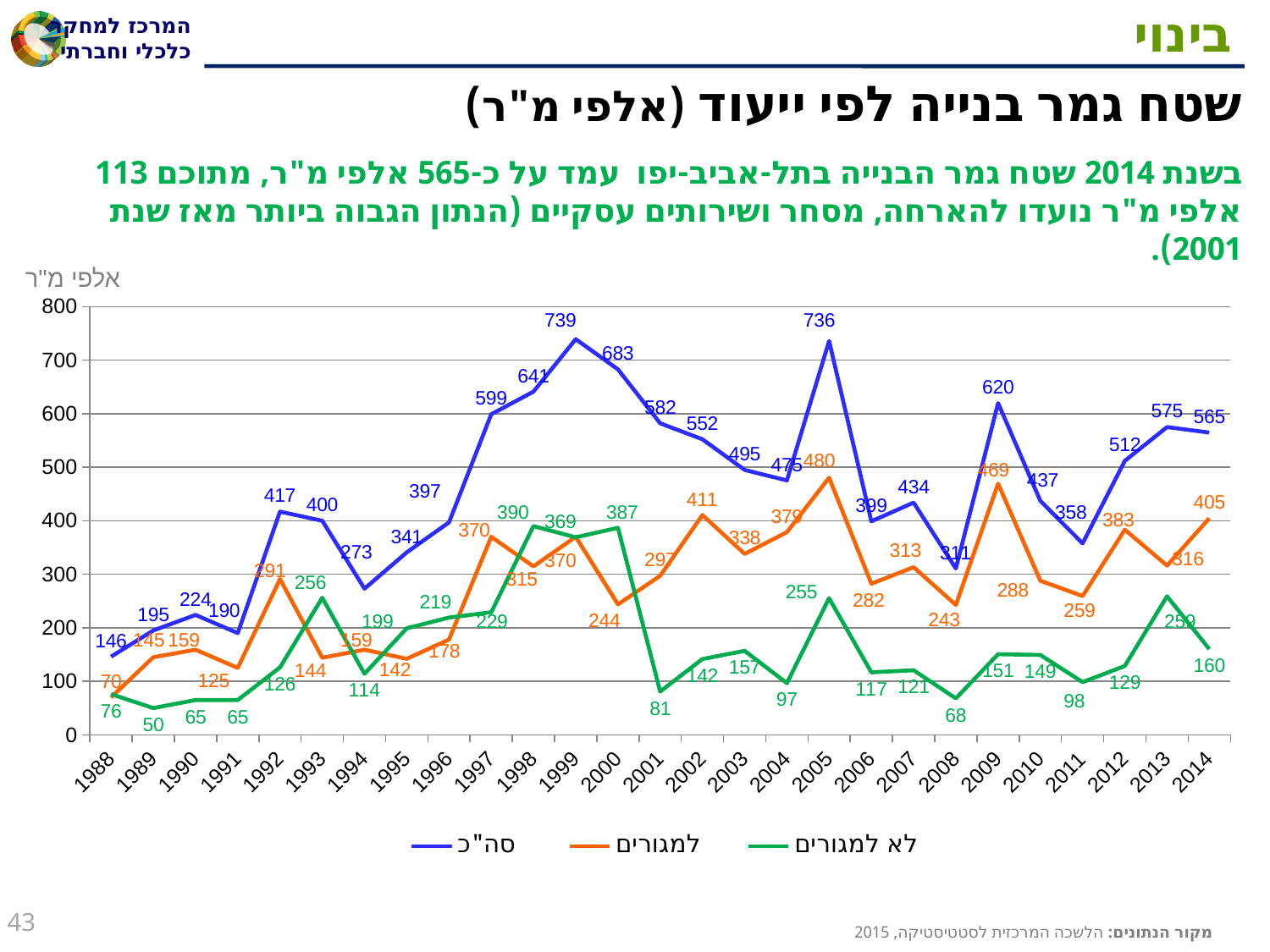
What is the value of the סה"כ series in 2014? 565 In which year does the סה"כ series reach its highest value? 1999 What is the value of the למגורים series in 2014? 405 How many series does the legend list? 3 What is the value of the לא למגורים series in 1998? 390 Does the סה"כ series rise or fall from 2011 to 2013? rise What is the unit label shown above the y axis? אלפי מ"ר How many years are plotted along the x axis? 27 What is the difference between the למגורים value and the לא למגורים value in 2014? 245 What kind of chart is shown on the slide? line chart In which year does the לא למגורים series reach its lowest value? 1989 Which is larger: the סה"כ value in 2005 or in 2009? 2005